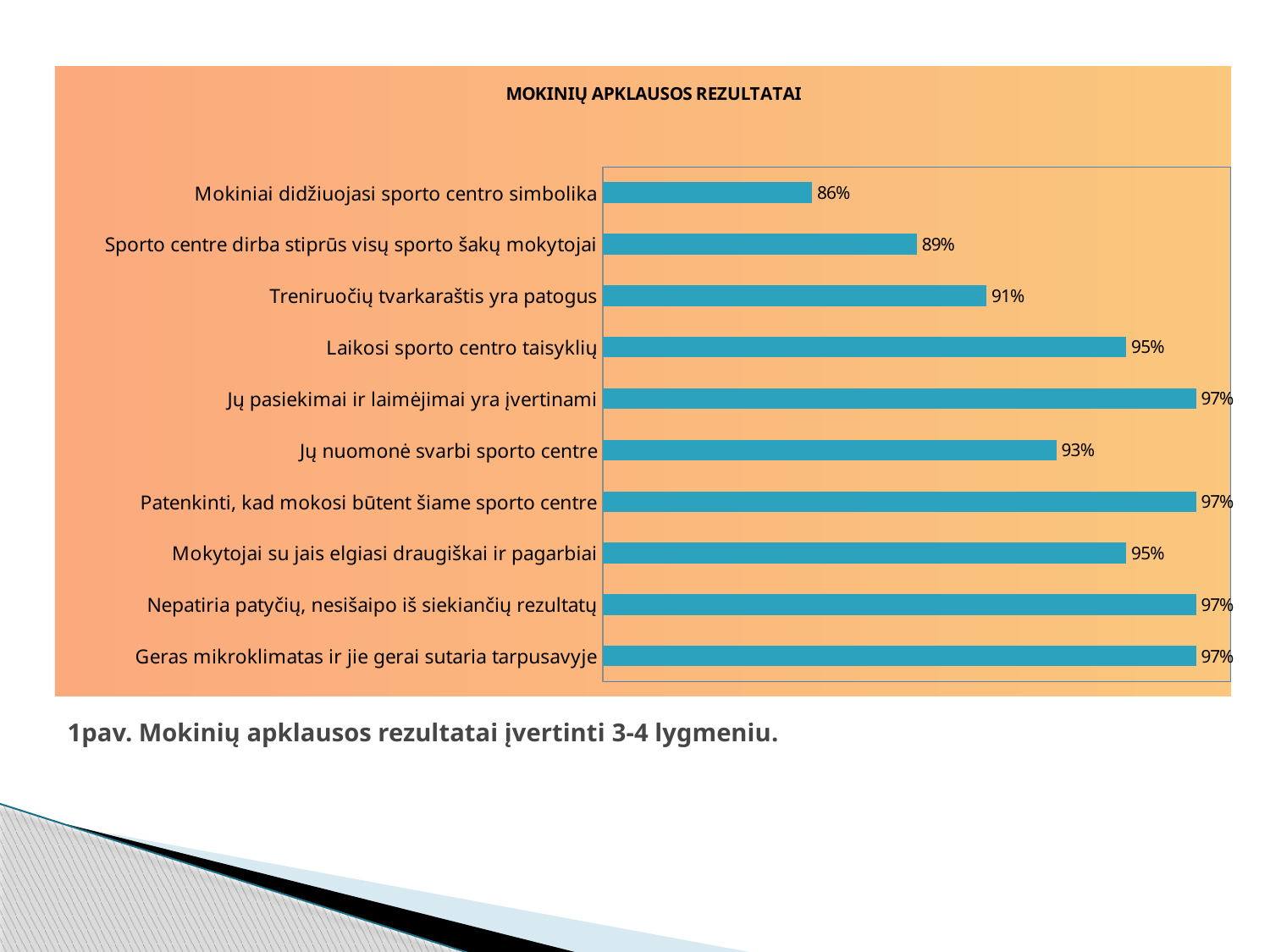
Which category has the lowest value? Mokiniai didžiuojasi sporto centro simbolika How many categories are shown in the chart? 10 What is the title of the chart? MOKINIŲ APKLAUSOS REZULTATAI What is the difference between the values for "Laikosi sporto centro taisyklių" and "Mokiniai didžiuojasi sporto centro simbolika"? 9% What is the value for "Geras mikroklimatas ir jie gerai sutaria tarpusavyje"? 97% What is the value for "Sporto centre dirba stiprūs visų sporto šakų mokytojai"? 89% What is the difference between the values for "Jų pasiekimai ir laimėjimai yra įvertinami" and "Jų nuomonė svarbi sporto centre"? 4% What is the value for "Mokiniai didžiuojasi sporto centro simbolika"? 86% What is the value for "Treniruočių tvarkaraštis yra patogus"? 91% What is the value for "Jų nuomonė svarbi sporto centre"? 93% What kind of chart is shown on the slide? Bar chart Which is larger: the value for "Treniruočių tvarkaraštis yra patogus" or the value for "Mokytojai su jais elgiasi draugiškai ir pagarbiai"? Mokytojai su jais elgiasi draugiškai ir pagarbiai